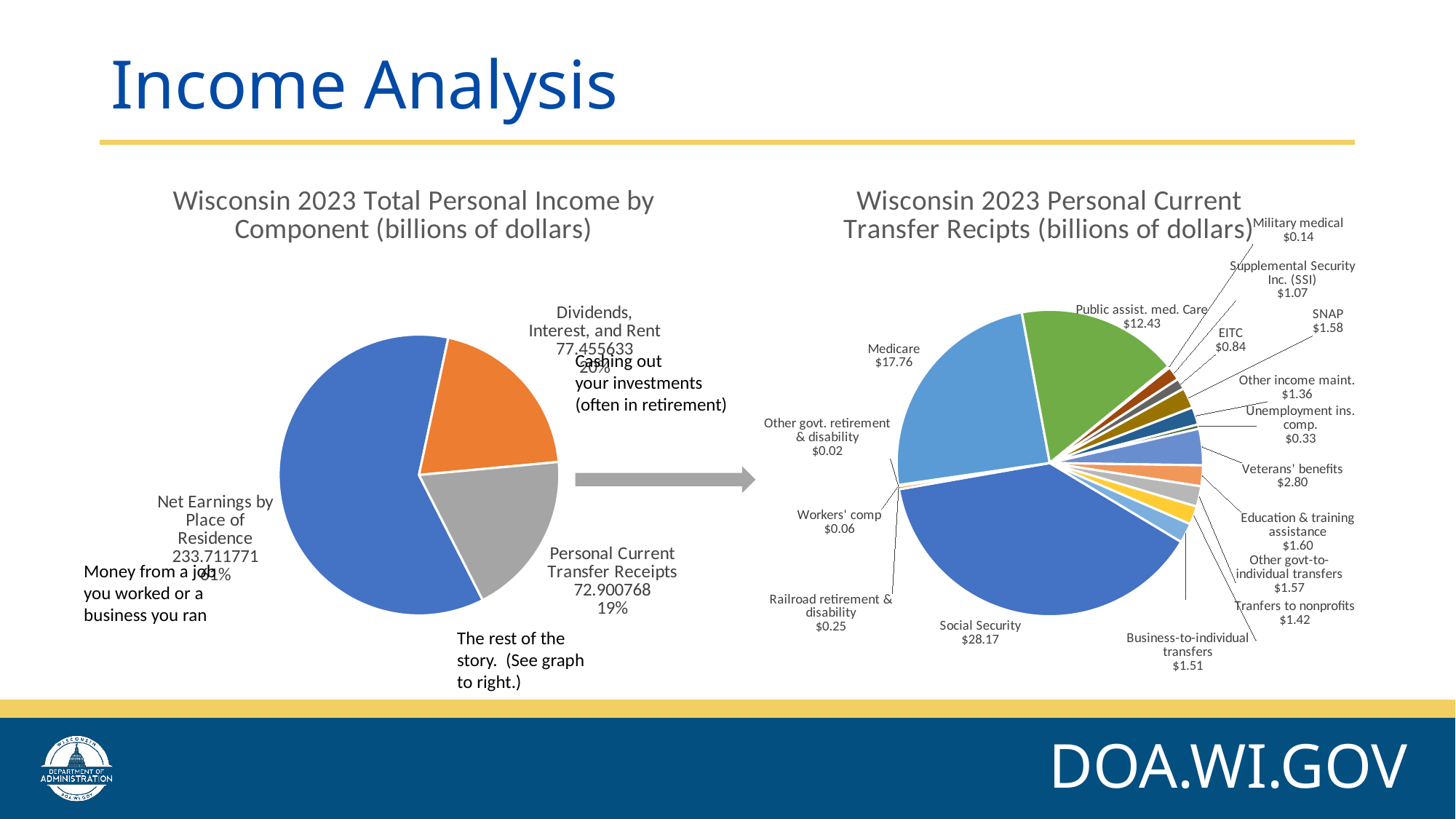
In the left chart, what is the value for Personal Current Transfer Receipts? 72.900768 In the right chart (Personal Current Transfer Receipts), which category is the smallest? Other govt. retirement & disability In the right chart (Personal Current Transfer Receipts), what is the value for Medicare? $17.76 In the left chart, what is the value for Net Earnings by Place of Residence? 233.711771 In the right chart (Personal Current Transfer Receipts), what is the difference between Social Security and Medicare? $10.41 In the left chart, what share of total personal income is Personal Current Transfer Receipts? 19% In the right chart (Personal Current Transfer Receipts), which is larger: Veterans' benefits or SNAP? Veterans' benefits How many slices does the right chart (Personal Current Transfer Receipts) have? 17 In the left chart, which component is the largest? Net Earnings by Place of Residence In the left chart, what is the difference between Dividends, Interest, and Rent and Personal Current Transfer Receipts? 4.554865 What type of chart is the 'Wisconsin 2023 Total Personal Income by Component' chart on the left? pie chart In the right chart (Personal Current Transfer Receipts), what is the value for Social Security? $28.17